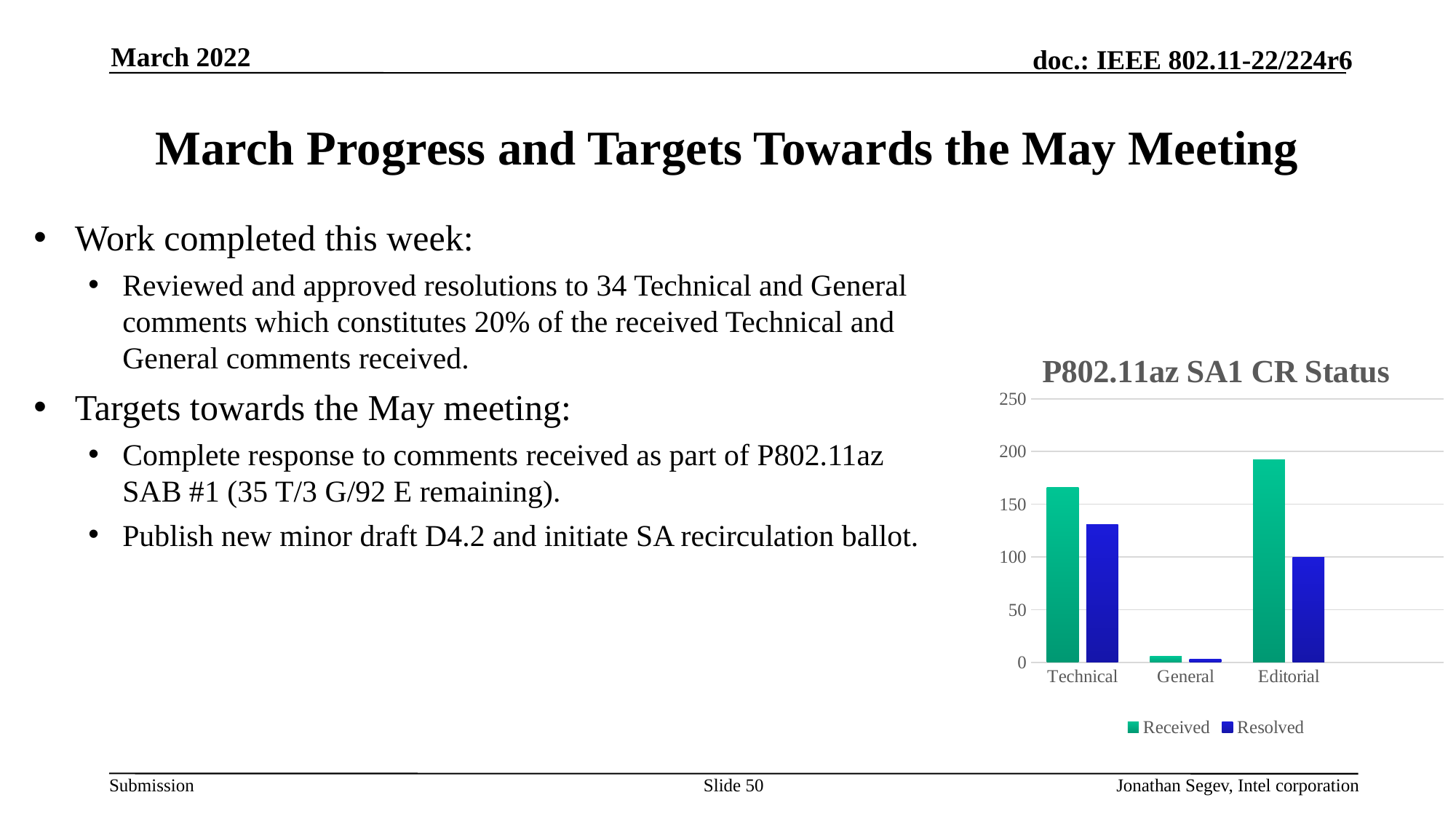
Which series is shown in dark blue in the chart legend? Resolved Which category has the highest Received value? Editorial Is the Received value for Editorial greater or less than 200? less Is the Received value for Technical greater or less than 150? greater How many categories are shown on the x axis of the chart? 3 Which category has the highest Resolved value? Technical What is the title of the chart? P802.11az SA1 CR Status Which category has the lowest Received value? General Which is larger, the Resolved value for Technical or the Resolved value for Editorial? Technical How many series does the chart legend list? 2 What kind of chart is shown on the slide? bar chart Which is larger, the Received value for Technical or the Received value for Editorial? Editorial